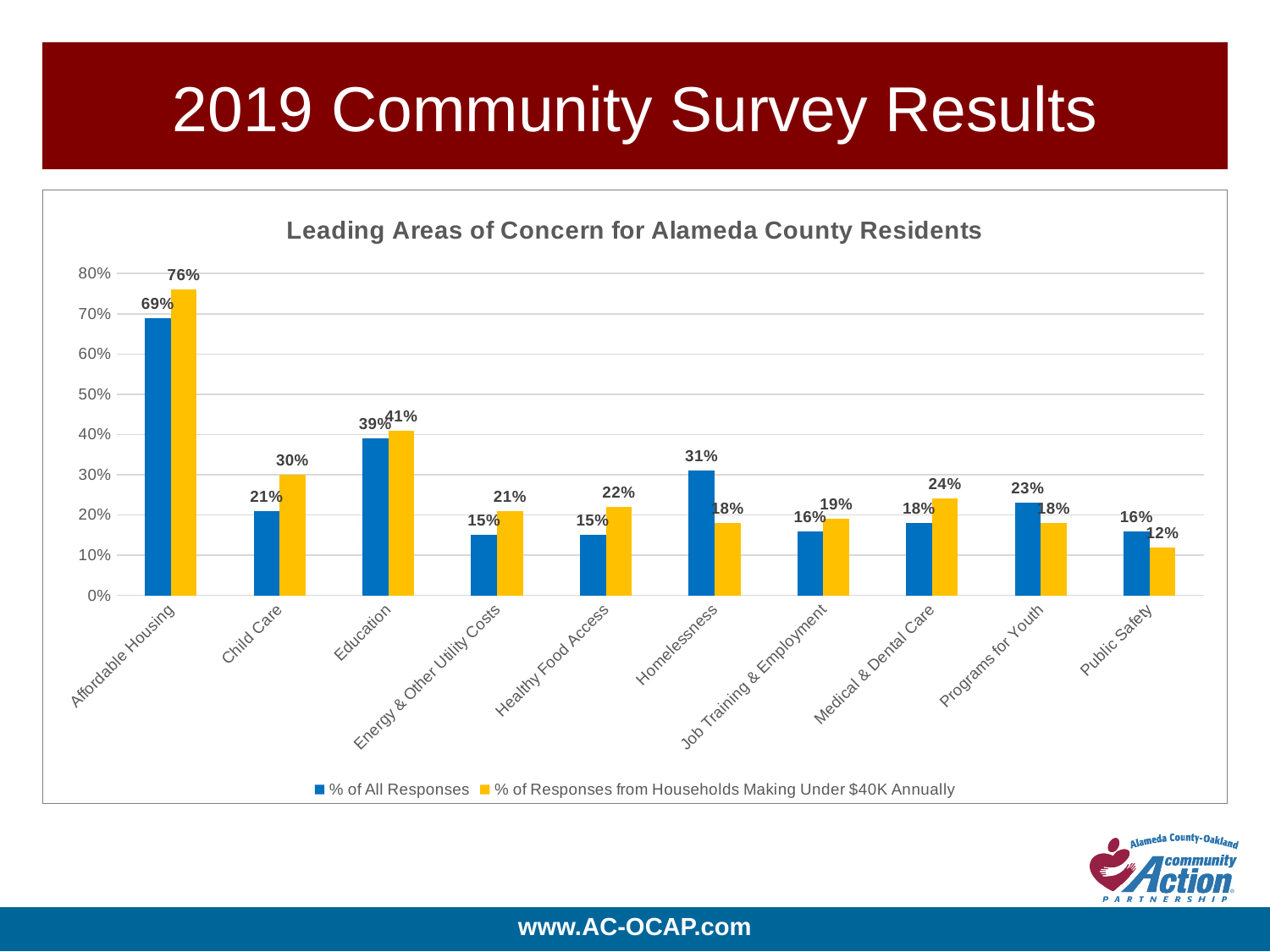
What is the difference between the two series for Affordable Housing? 7% What is the value for Child Care in the % of Responses from Households Making Under $40K Annually series? 30% What kind of chart is shown on the slide? Bar chart Which category has the highest value in the % of Responses from Households Making Under $40K Annually series? Affordable Housing Which category has the lowest value in the % of Responses from Households Making Under $40K Annually series? Public Safety What is the value for Affordable Housing in the % of All Responses series? 69% How many categories are shown on the x axis? 10 For Homelessness, which series has the larger value: % of All Responses or % of Responses from Households Making Under $40K Annually? % of All Responses What is the title of the chart? Leading Areas of Concern for Alameda County Residents What is the difference between the two series for Medical & Dental Care? 6% How many series does the legend list? 2 What is the value for Homelessness in the % of All Responses series? 31%